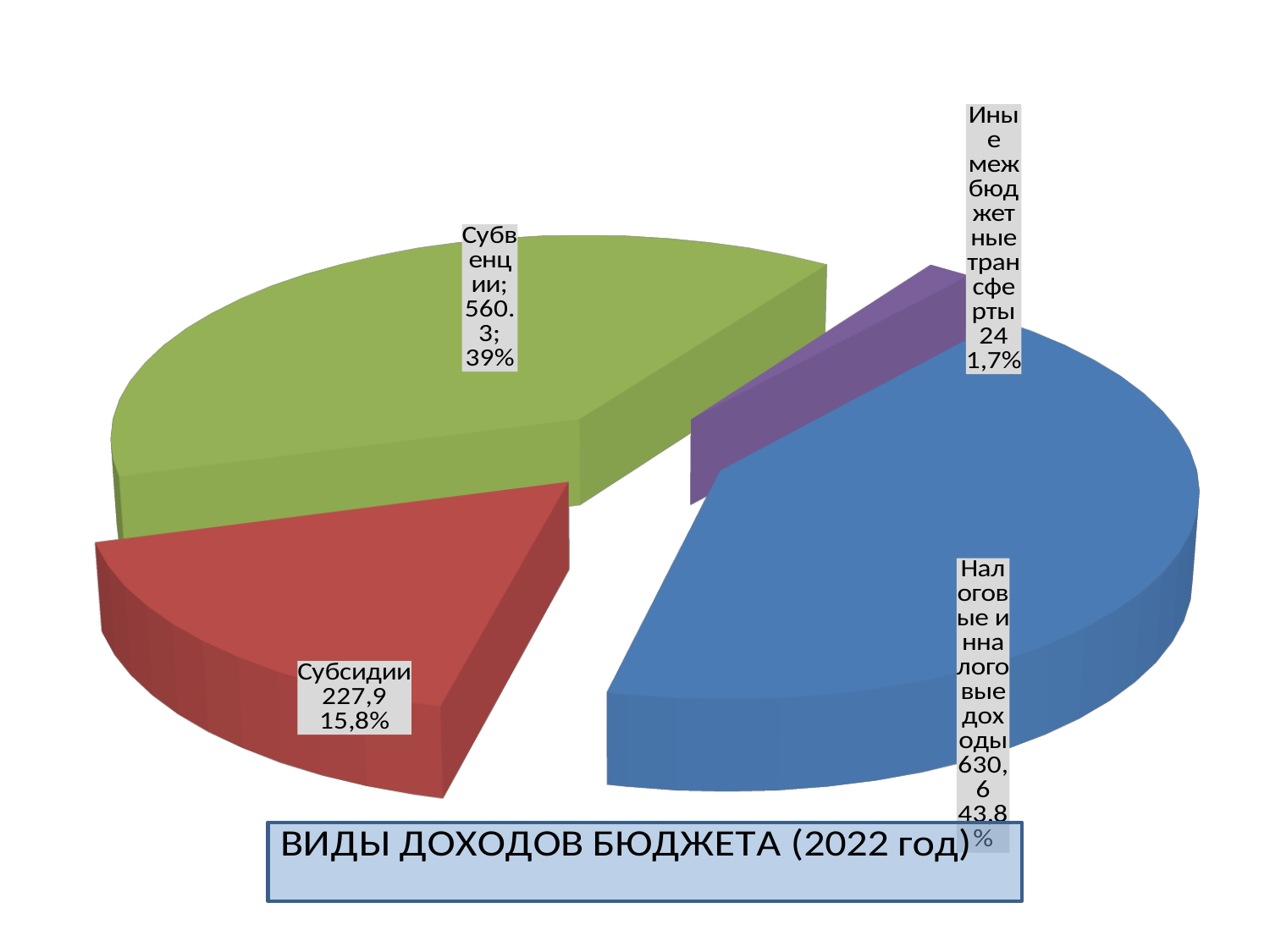
What kind of chart is shown on the slide? pie chart What value is shown for Налоговые и нналоговые доходы? 630,6 What percentage share is shown for Субсидии? 15,8% What value is shown for Субсидии? 227,9 What value is shown for Субвенции? 560.3 What percentage share is shown for Субвенции? 39% Which category has the smallest slice of the pie? Иные межбюджетные трансферты What is the title of the chart? ВИДЫ ДОХОДОВ БЮДЖЕТА (2022 год) How many slices does the pie chart have? 4 Which is larger, the value for Субвенции or the value for Субсидии? Субвенции What percentage share is shown for Иные межбюджетные трансферты? 1,7% Which category has the largest slice of the pie? Налоговые и нналоговые доходы